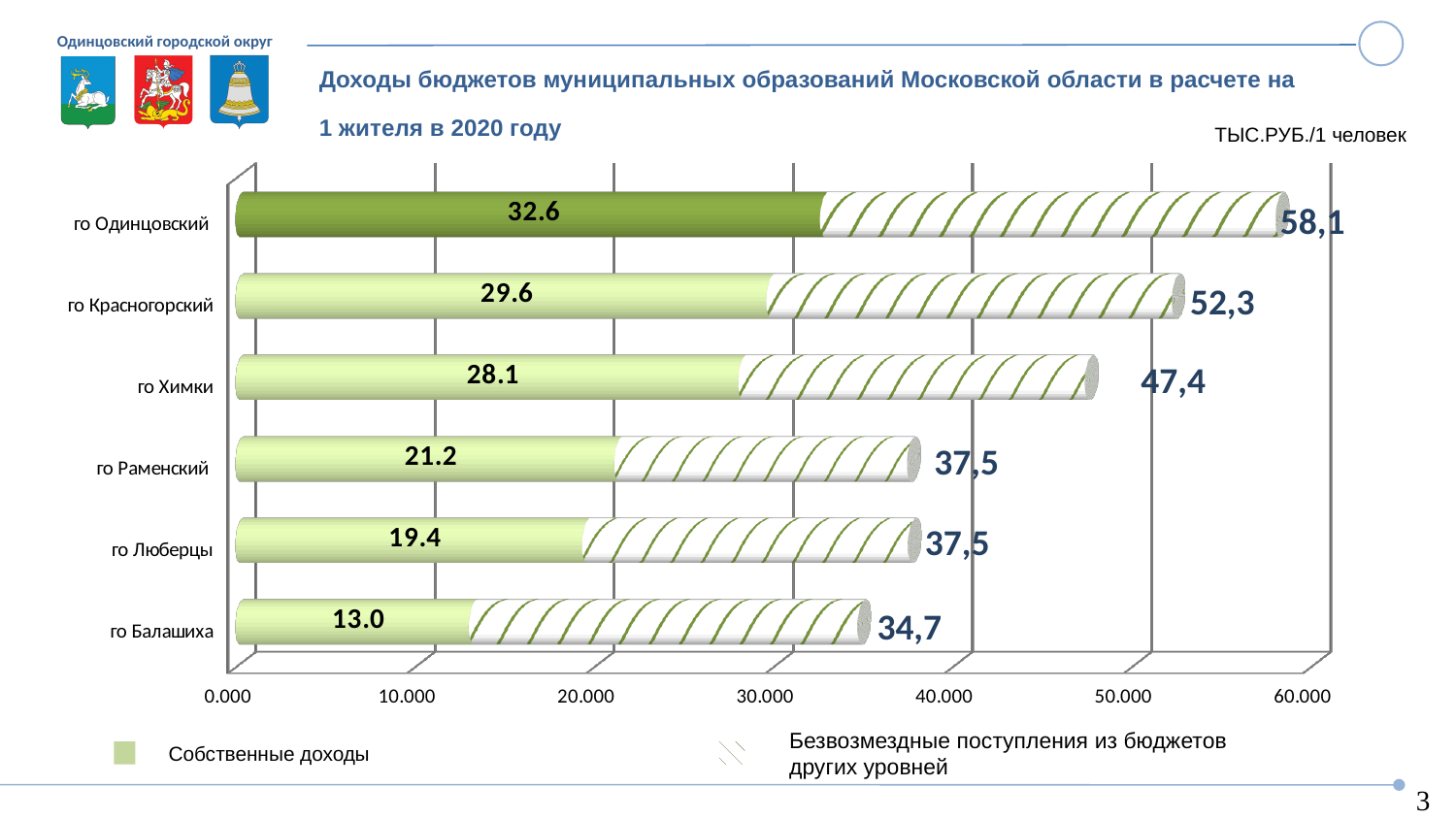
What is the value of own revenues (Собственные доходы) for го Одинцовский? 32.6 Which municipality has the lowest own revenues per resident? го Балашиха What is the difference in own revenues between го Одинцовский and го Красногорский? 3.0 What is the total of the stacked bar for го Красногорский? 52,3 What is the value of own revenues for го Балашиха? 13.0 Which has larger own revenues per resident, го Раменский or го Люберцы? го Раменский What kind of chart is shown on the slide? bar chart How many municipalities are shown in the chart? 6 What unit is indicated for the values in the chart? ТЫС.РУБ./1 человек How many series does the legend list? 2 Which municipality has the highest total revenue per resident? го Одинцовский What is the total budget revenue per resident for го Химки? 47,4